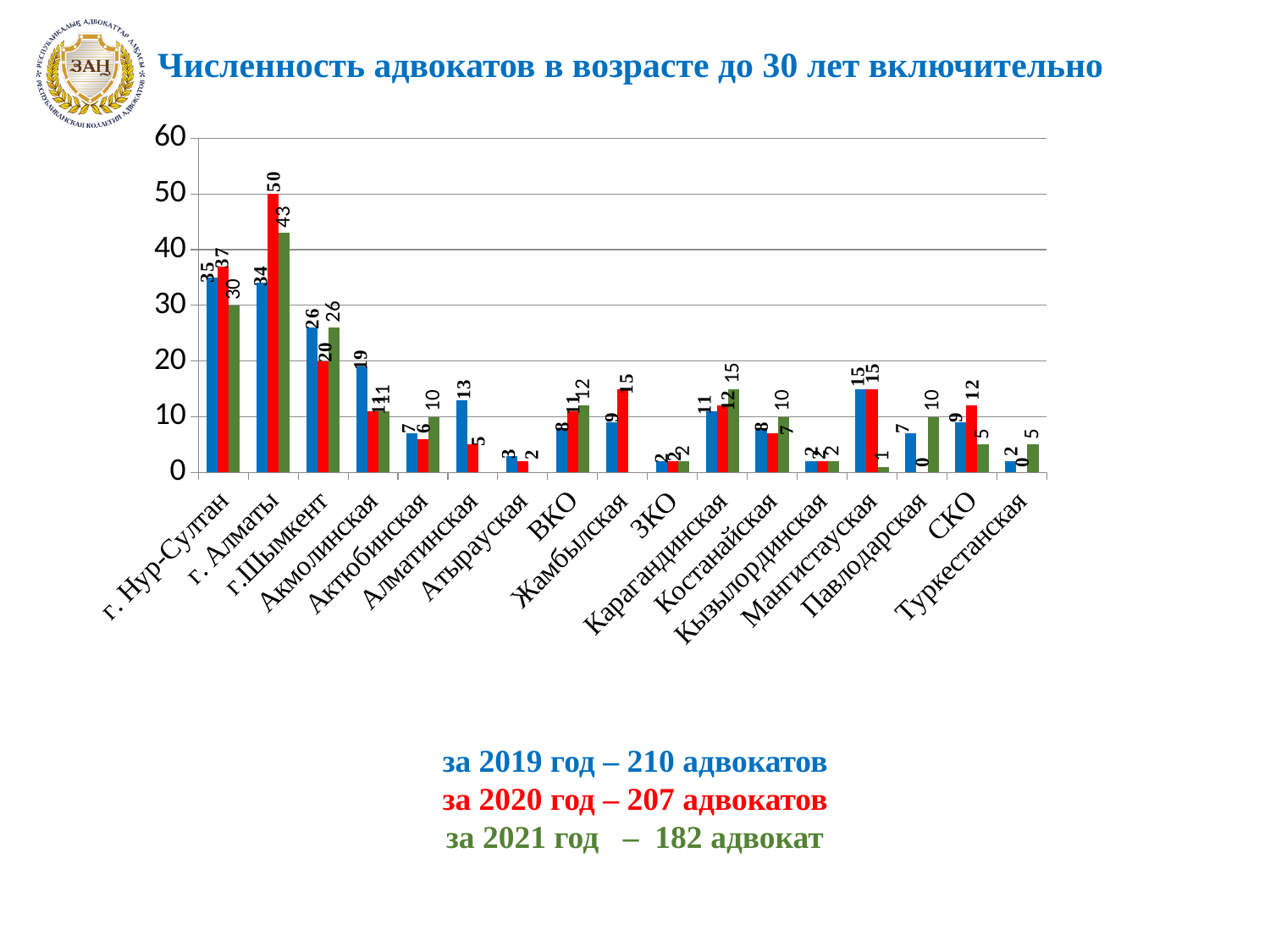
How many bars are plotted for each region in the chart? 3 Which is larger for г.Шымкент: the blue (2019) bar or the red (2020) bar? blue (2019) What is the value of the green (2021) bar for Карагандинская? 15 According to the text below the chart, how many advocates were there in 2021? 182 What is the value of the green (2021) bar for г. Нур-Султан? 30 What is the title of the chart? Численность адвокатов в возрасте до 30 лет включительно Which region has the highest single bar in the chart? г. Алматы How many regions (categories) are shown on the x axis of the chart? 17 What is the difference between the red (2020) bar and the green (2021) bar for г. Алматы? 7 What is the value of the red (2020) bar for г. Алматы? 50 What is the value of the blue (2019) bar for Акмолинская? 19 What type of chart is shown on the slide? bar chart